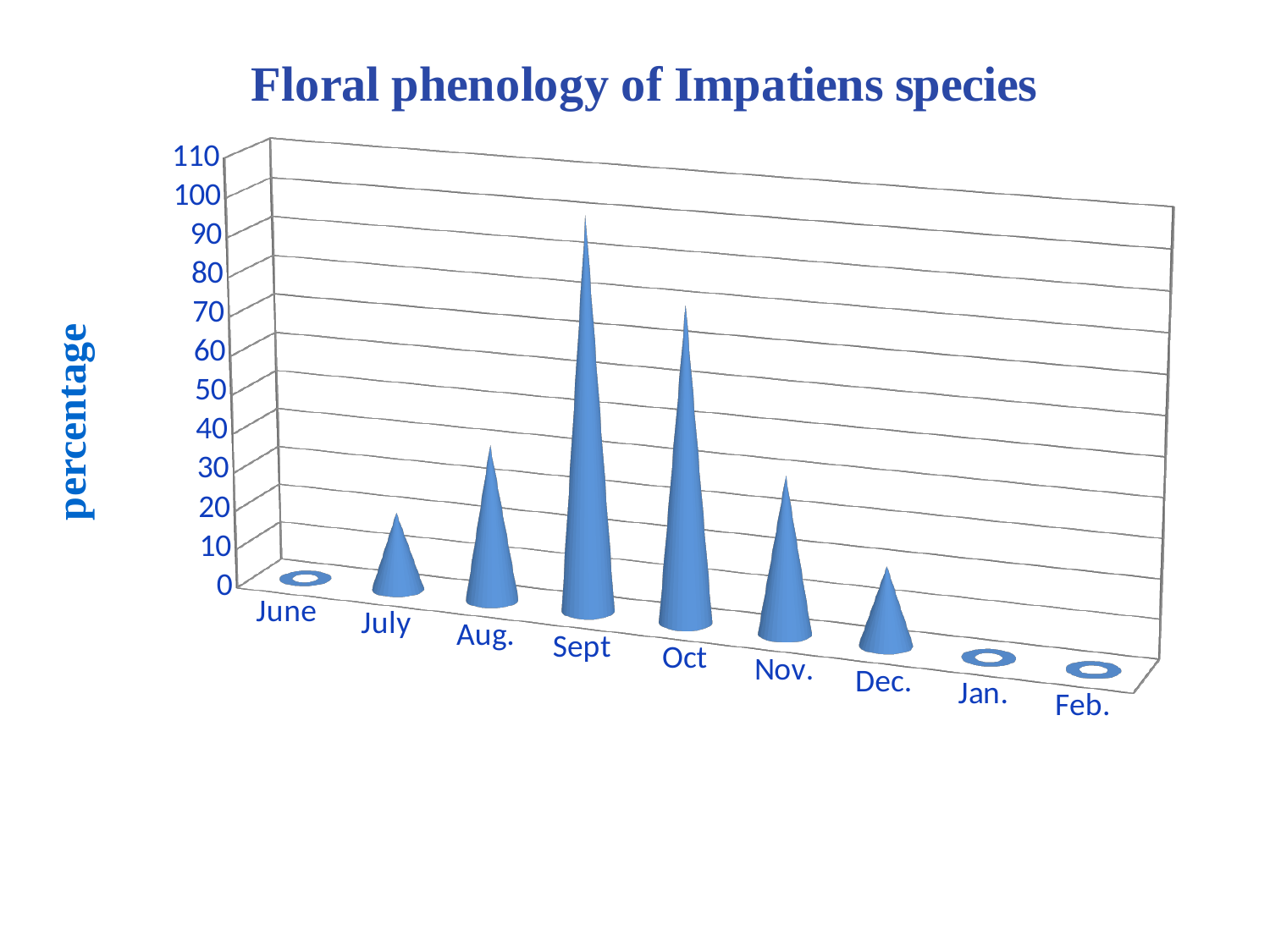
What kind of chart is shown on the slide? bar chart How do the values change from June to Sept? They rise Is the value for July greater or less than 30? less Which month has the highest percentage? Sept How many months are shown on the x axis? 9 Is the value for Sept greater or less than 50? greater Which is larger, the value for Aug. or the value for July? Aug. What is the label on the vertical axis? percentage What is the title of the chart? Floral phenology of Impatiens species Which is larger, the value for Sept or the value for Oct? Sept Is the value for Nov greater or less than 60? less